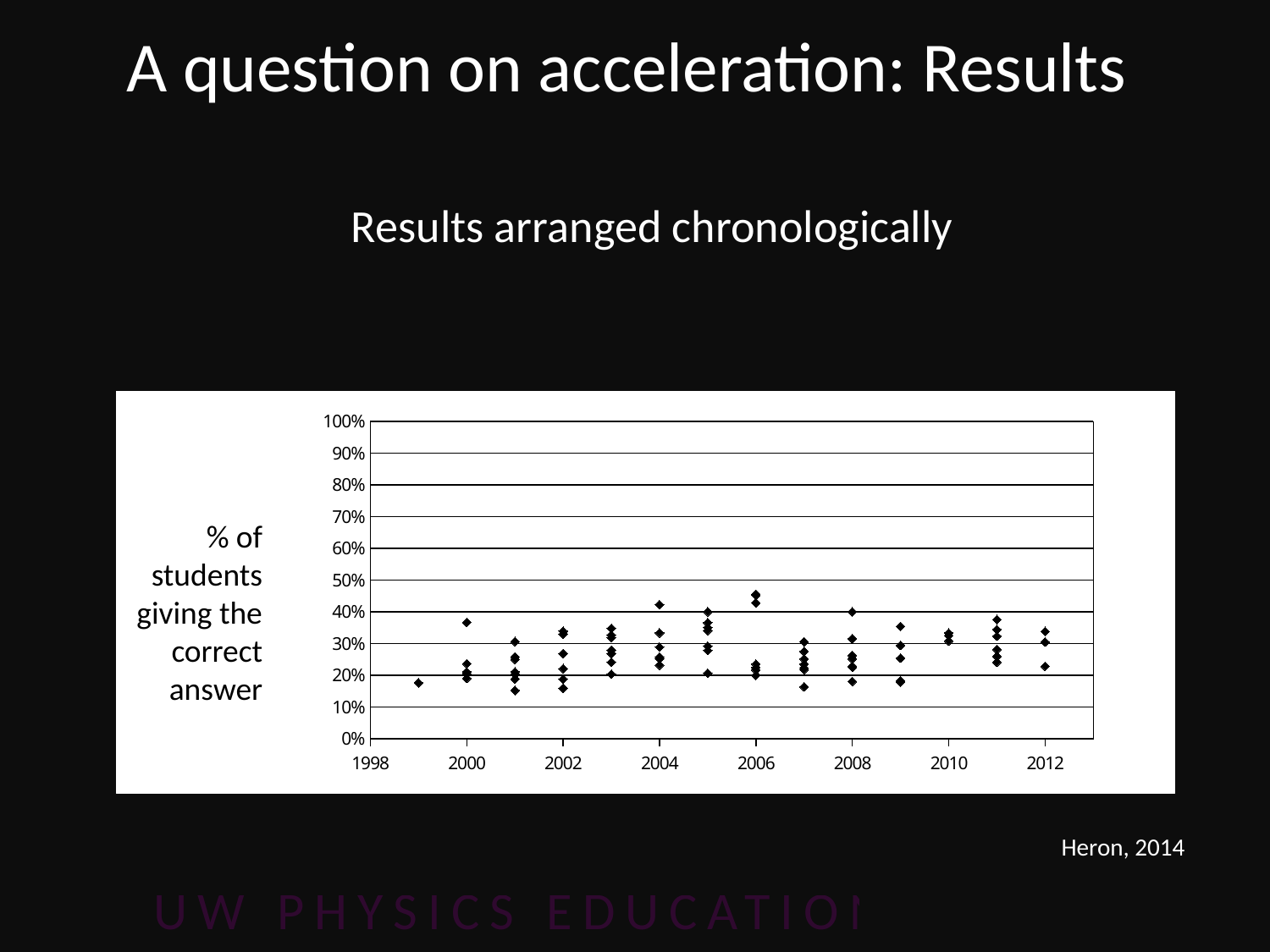
What is the highest value shown on the vertical axis of the chart? 100% What kind of chart is shown on the slide? Scatter plot Is the single data point for 1999 greater or less than 20%? less Is the lowest data point for 2007 greater or less than 20%? less Is the highest data point for 2006 greater or less than 40%? greater What is the label on the vertical axis of the chart? % of students giving the correct answer How many different years have data points plotted on the chart? 14 How many data points are plotted for the year 1999? 1 Do the plotted values show a clear rising or falling trend from 1999 to 2012? No clear trend; roughly flat